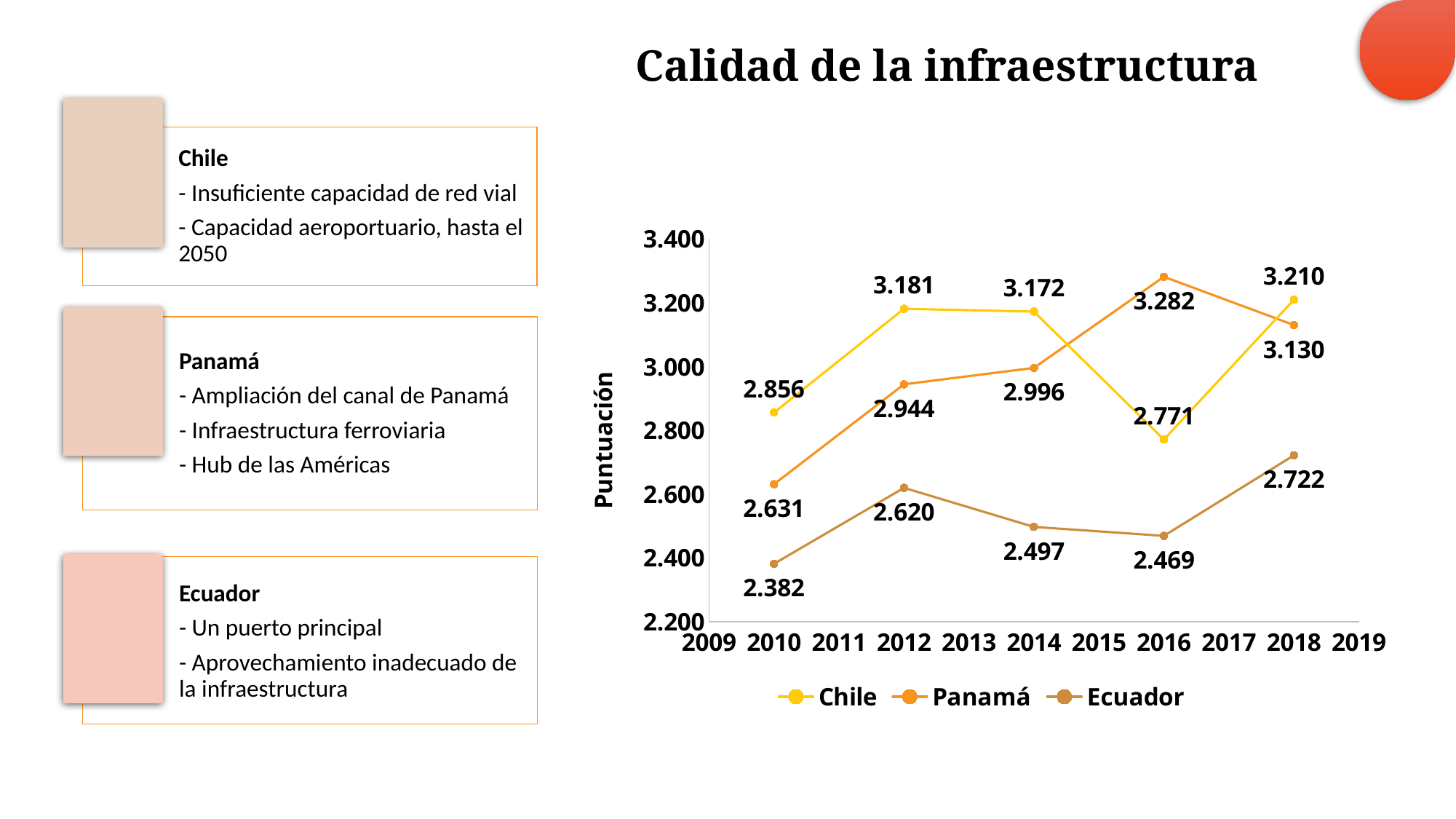
What is the difference between Chile's and Panamá's scores in 2018? 0.080 In which year does Ecuador reach its highest score? 2018 What is Ecuador's score in 2010? 2.382 By how much did Ecuador's score increase from 2010 to 2018? 0.340 In which year does Chile have its lowest score? 2016 What is Panamá's score in 2016? 3.282 How many data points are plotted for each country? 5 Which country has the higher score in 2016, Chile or Panamá? Panamá Is Ecuador's score in 2014 greater or less than 2.600? less What is Chile's score in 2018? 3.210 What type of chart is shown on the slide? Line chart How many series does the legend list? 3